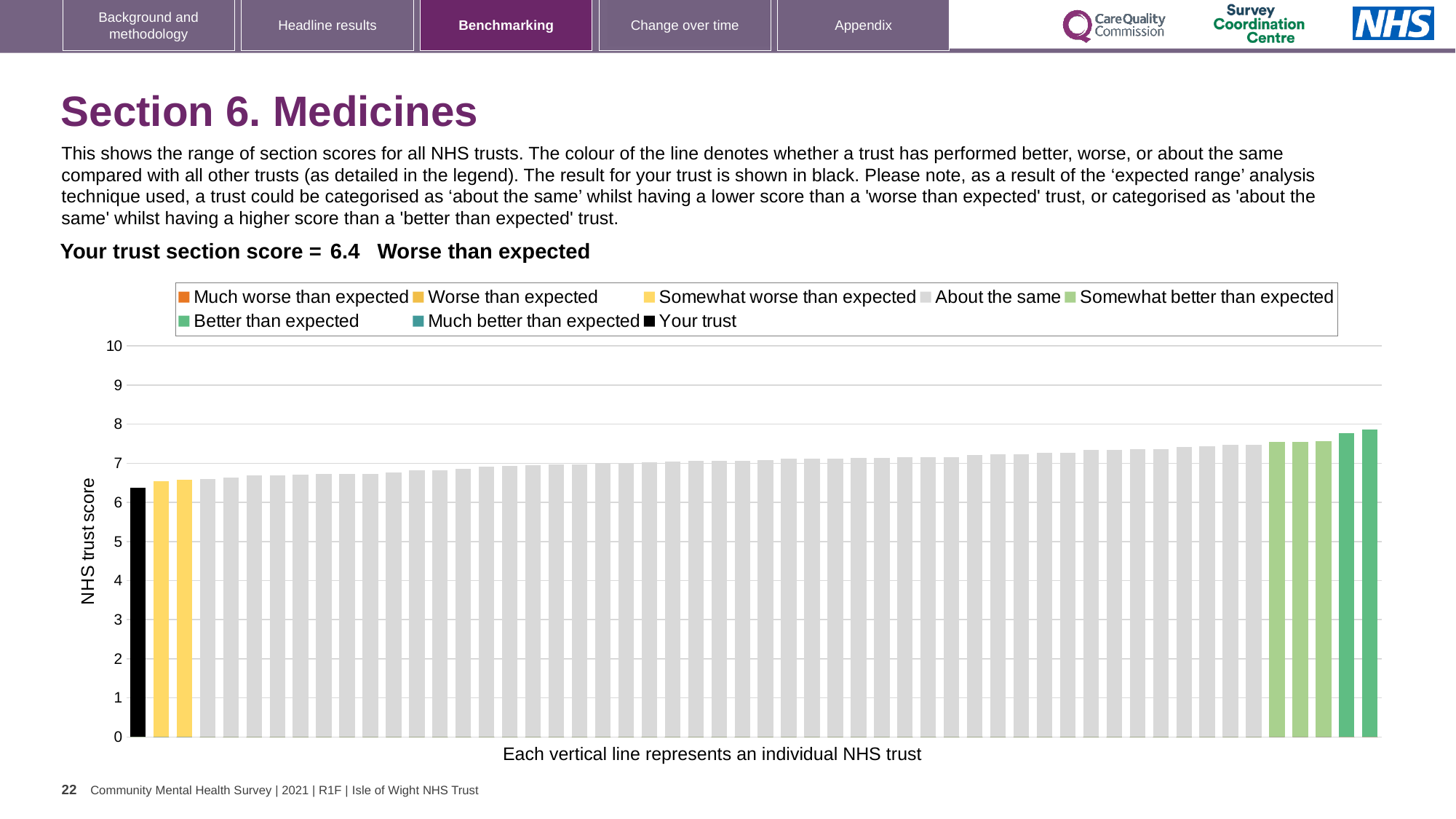
Which benchmarking category is your trust's section score placed in? Worse than expected What is the label on the vertical axis of the chart? NHS trust score Which bar on the chart is the lowest? the black bar for your trust What kind of chart is shown on the slide? bar chart What colour is the bar representing your trust? black Is the value of the tallest bar on the chart greater or less than 7? greater Is the value of the black bar for your trust greater or less than 7? less Is the value of the tallest bar on the chart greater or less than 8? less What is the section score for your trust shown on the slide? 6.4 Do the bar values rise or fall from left to right along the x axis? rise How many entries does the chart legend list? 8